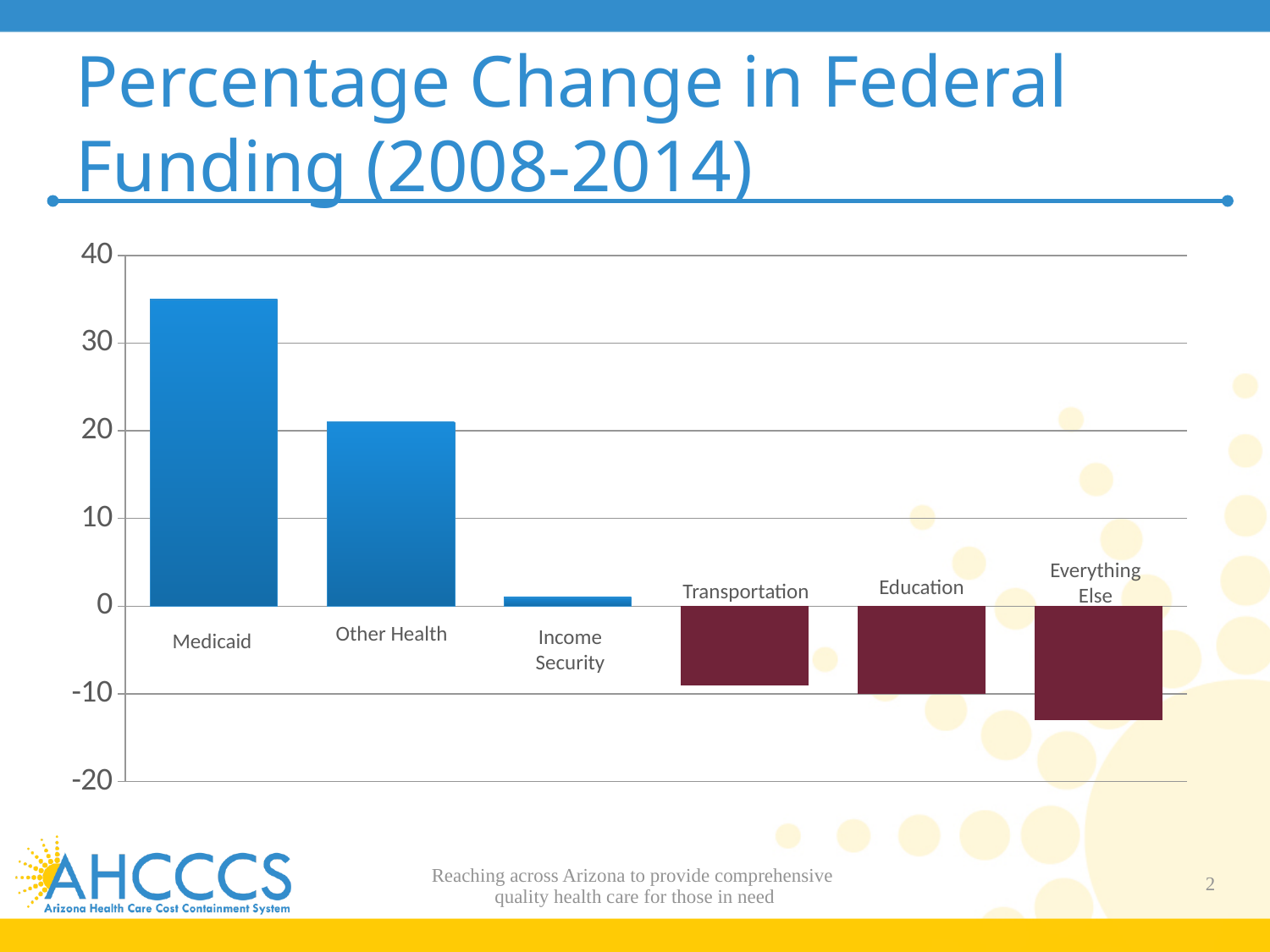
Do the values rise or fall moving from left to right across the categories? Fall Which category has the lowest percentage change in federal funding? Everything Else Is the value for Income Security greater or less than 10? less Which is larger, the value for Transportation or the value for Everything Else? Transportation Is the value for Medicaid greater or less than 30? greater What type of chart is shown on the slide? Bar chart Is the value for Everything Else greater or less than -10? less Which is larger, the value for Medicaid or the value for Other Health? Medicaid What is the title of the chart on the slide? Percentage Change in Federal Funding (2008-2014) How many categories are shown in the chart? 6 Which category has the highest percentage change in federal funding? Medicaid